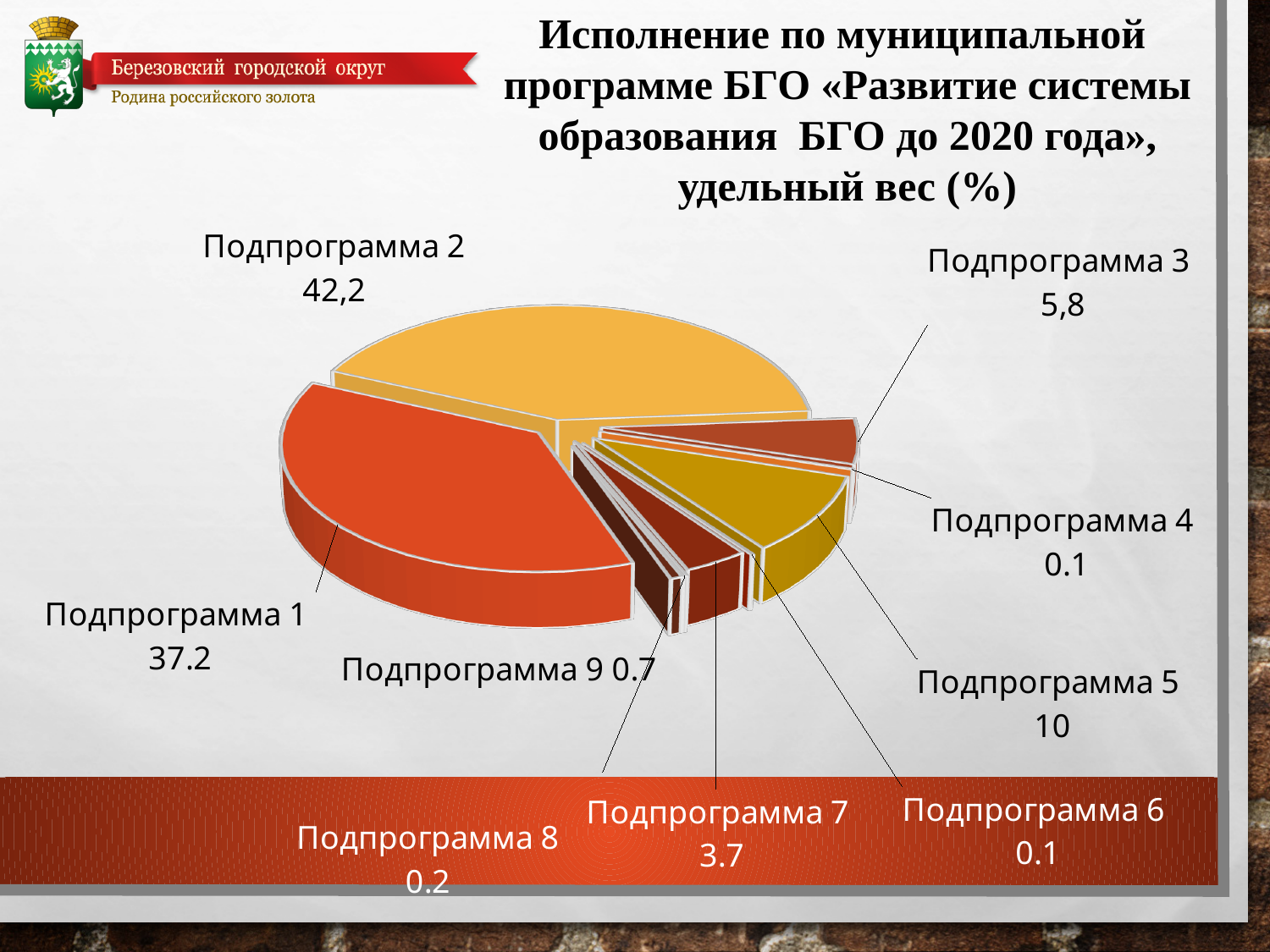
Which subprogram has the largest share of the pie? Подпрограмма 2 What is the value for Подпрограмма 9? 0.7 What is the value for Подпрограмма 5? 10 What type of chart is shown on the slide? pie chart What is the difference between the values for Подпрограмма 2 and Подпрограмма 1? 5 Which is larger, the value for Подпрограмма 3 or the value for Подпрограмма 5? Подпрограмма 5 What is the value for Подпрограмма 2? 42,2 What unit does the chart title say the values are expressed in? удельный вес (%) How many subprograms (slices) are shown in the pie chart? 9 What is the difference between the values for Подпрограмма 7 and Подпрограмма 9? 3 What is the value for Подпрограмма 1? 37.2 What is the value for Подпрограмма 7? 3.7